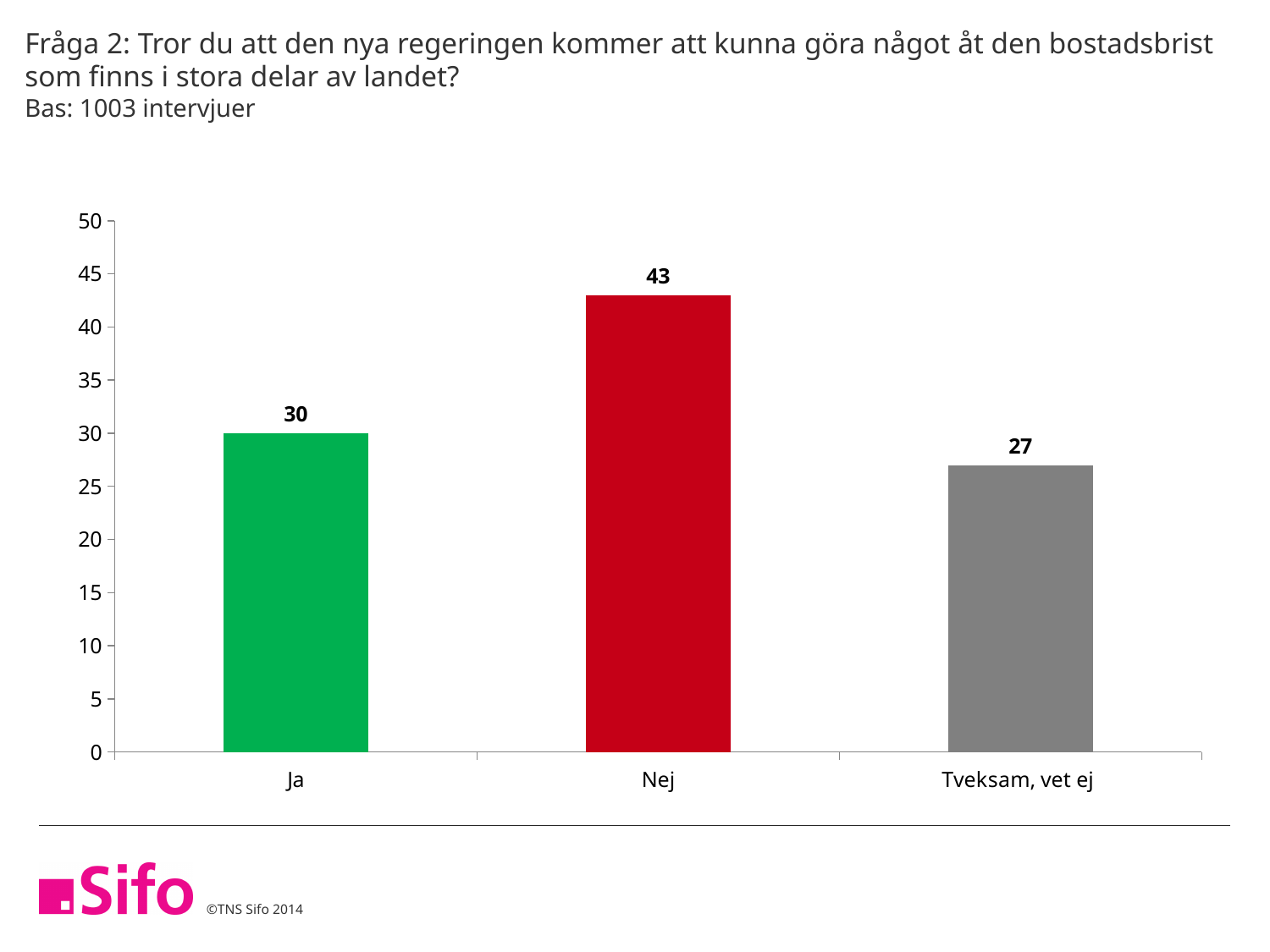
What is the difference between the values for Nej and Ja? 13 What is the difference between the values for Ja and Tveksam, vet ej? 3 How many categories are shown on the x axis? 3 Is the value for Nej greater or less than 40? greater Which is larger, the value for Ja or the value for Nej? Nej What is the value for Tveksam, vet ej? 27 What colour is the bar for Nej? red What is the value for Nej? 43 What kind of chart is shown on the slide? bar chart Which category has the highest value? Nej Which category has the lowest value? Tveksam, vet ej What is the value for Ja? 30